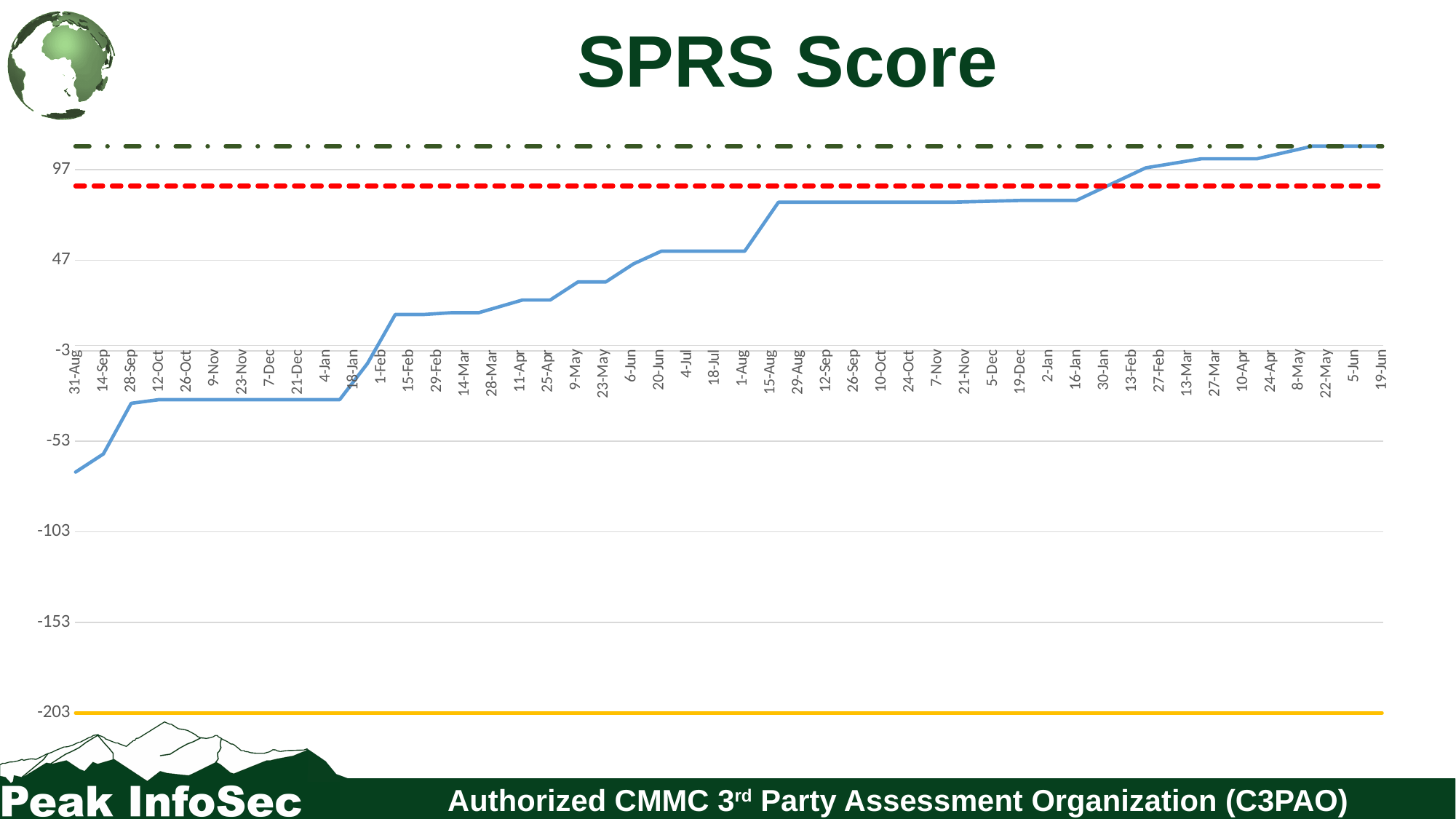
What is the title of the chart? SPRS Score Is the SPRS score on 31-Aug greater or less than -53? less How many dates are labelled on the x axis? 48 What kind of chart is shown on the slide? line chart Is the SPRS score on 19-Jun greater or less than 97? greater Is the SPRS score on 15-Aug greater or less than 97? less Which date has the larger SPRS score, 1-Aug or 15-Aug? 15-Aug What is the lowest value labelled on the y axis? -203 Does the SPRS score generally rise or fall from 31-Aug to 19-Jun? rise Which date has the lowest SPRS score on the chart? 31-Aug